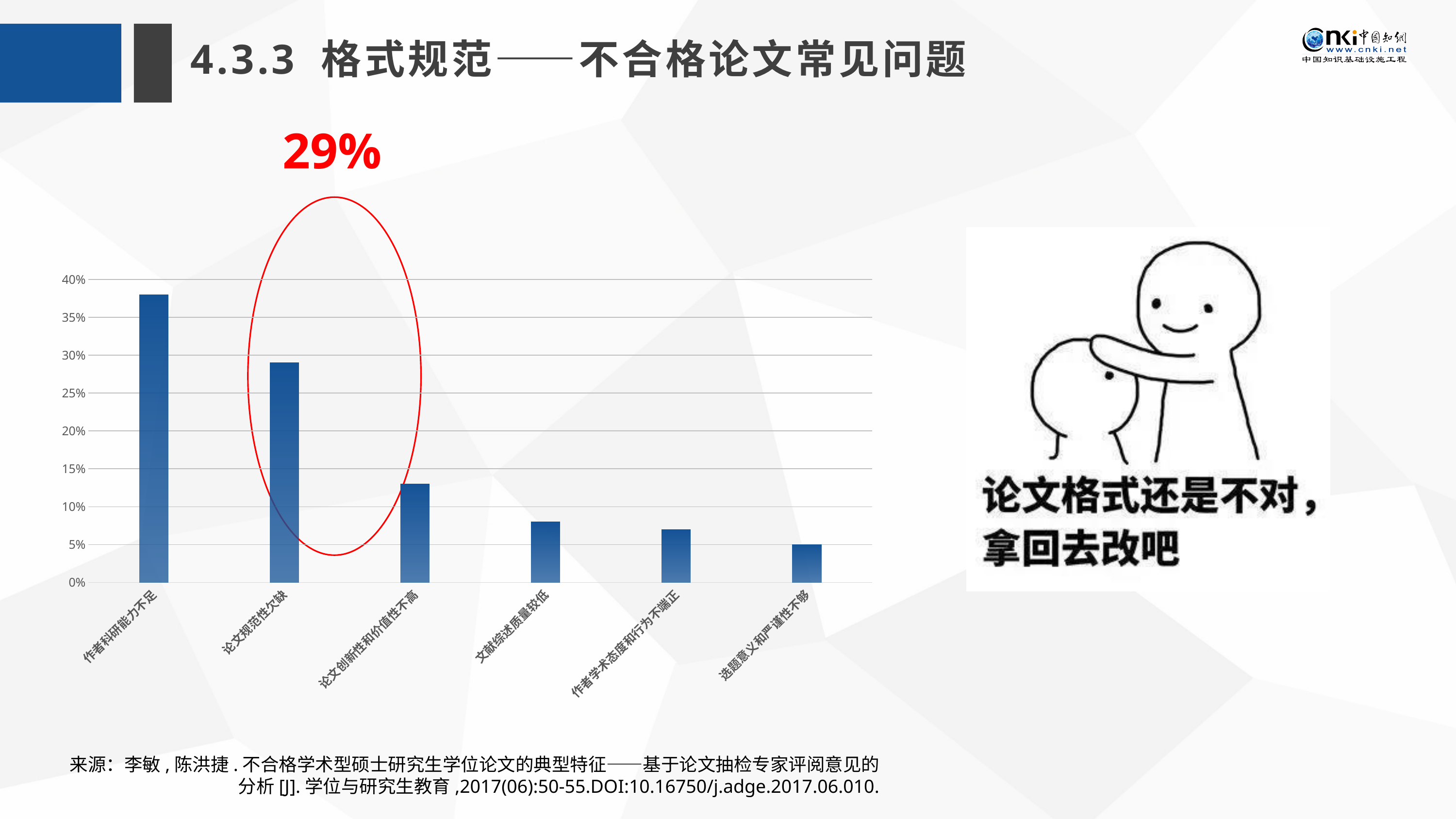
What is the value for 论文规范性欠缺? 29% How many categories are plotted in the bar chart? 6 Which is larger, the value for 论文创新性和价值性不高 or the value for 作者学术态度和行为不端正? 论文创新性和价值性不高 Which category has the highest value in the chart? 作者科研能力不足 Which category has the lowest value in the chart? 选题意义和严谨性不够 Do the bar values rise or fall from left to right along the x axis? fall Is the value for 作者科研能力不足 greater or less than 35%? greater What is the value for 选题意义和严谨性不够? 5% Is the value for 文献综述质量较低 greater or less than 10%? less Which category's bar is circled in red on the chart? 论文规范性欠缺 Is the value for 论文创新性和价值性不高 greater or less than 15%? less What kind of chart is shown on the slide? bar chart